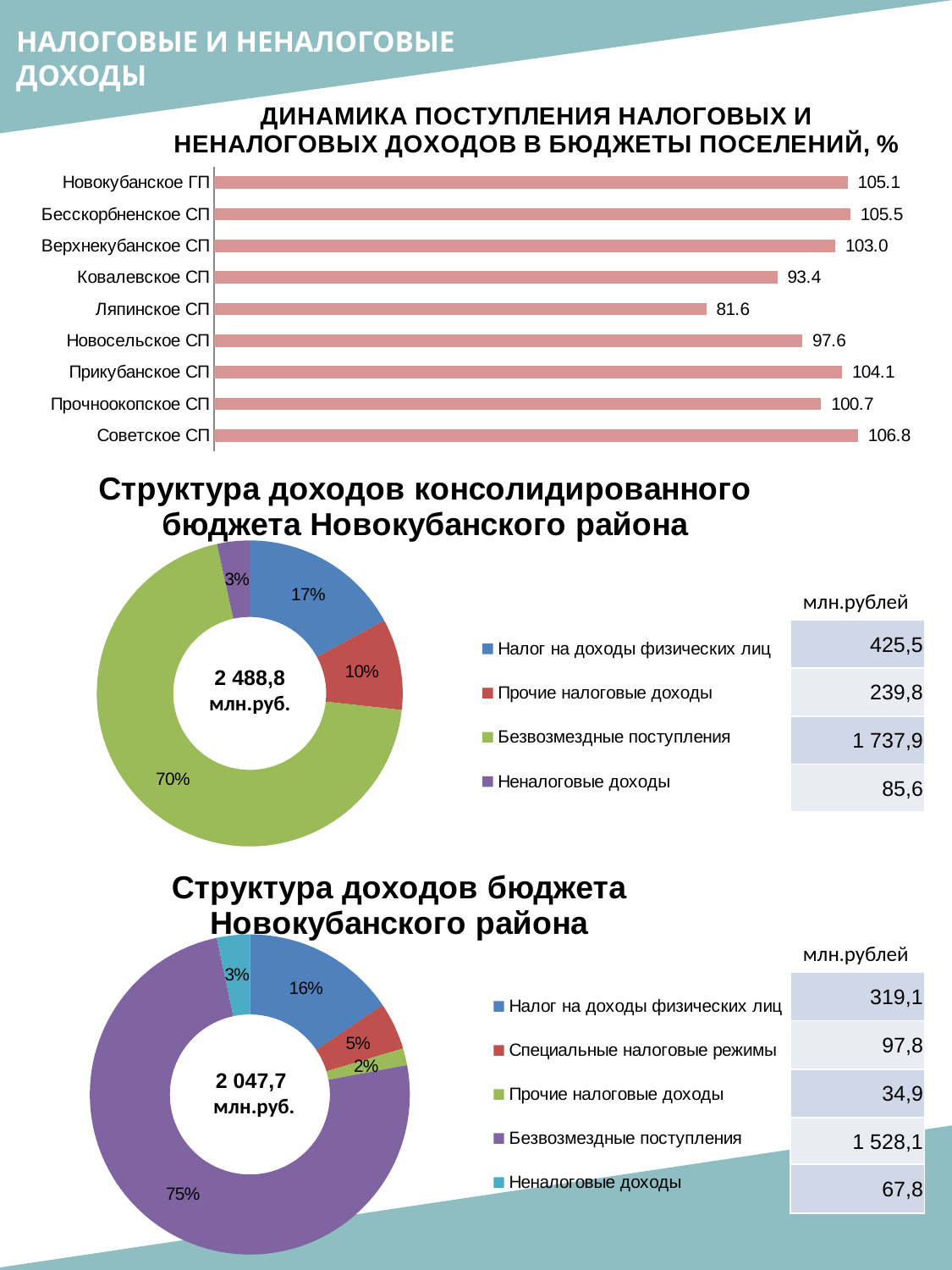
In the bar chart at the top of the slide, what is the value for Прочноокопское СП? 100.7 In the bar chart at the top of the slide, which settlement has the highest value? Советское СП In the chart 'Структура доходов бюджета Новокубанского района' at the bottom of the slide, what share does Специальные налоговые режимы have? 5% How many series does the legend list in the chart 'Структура доходов бюджета Новокубанского района' at the bottom of the slide? 5 In the chart 'Структура доходов консолидированного бюджета Новокубанского района', what share does Безвозмездные поступления have? 70% In the chart 'Структура доходов консолидированного бюджета Новокубанского района', what is the value in млн.рублей for Налог на доходы физических лиц? 425,5 How many settlements are shown in the bar chart at the top of the slide? 9 What type of chart is the top chart on the slide? Bar chart In the bar chart at the top of the slide, which is larger: the value for Ковалевское СП or the value for Новосельское СП? Новосельское СП In the bar chart 'ДИНАМИКА ПОСТУПЛЕНИЯ НАЛОГОВЫХ И НЕНАЛОГОВЫХ ДОХОДОВ В БЮДЖЕТЫ ПОСЕЛЕНИЙ, %', what is the value for Ляпинское СП? 81.6 In the bar chart at the top of the slide, what is the difference between the values for Советское СП and Ляпинское СП? 25.2 In the bar chart at the top of the slide, which settlement has the lowest value? Ляпинское СП